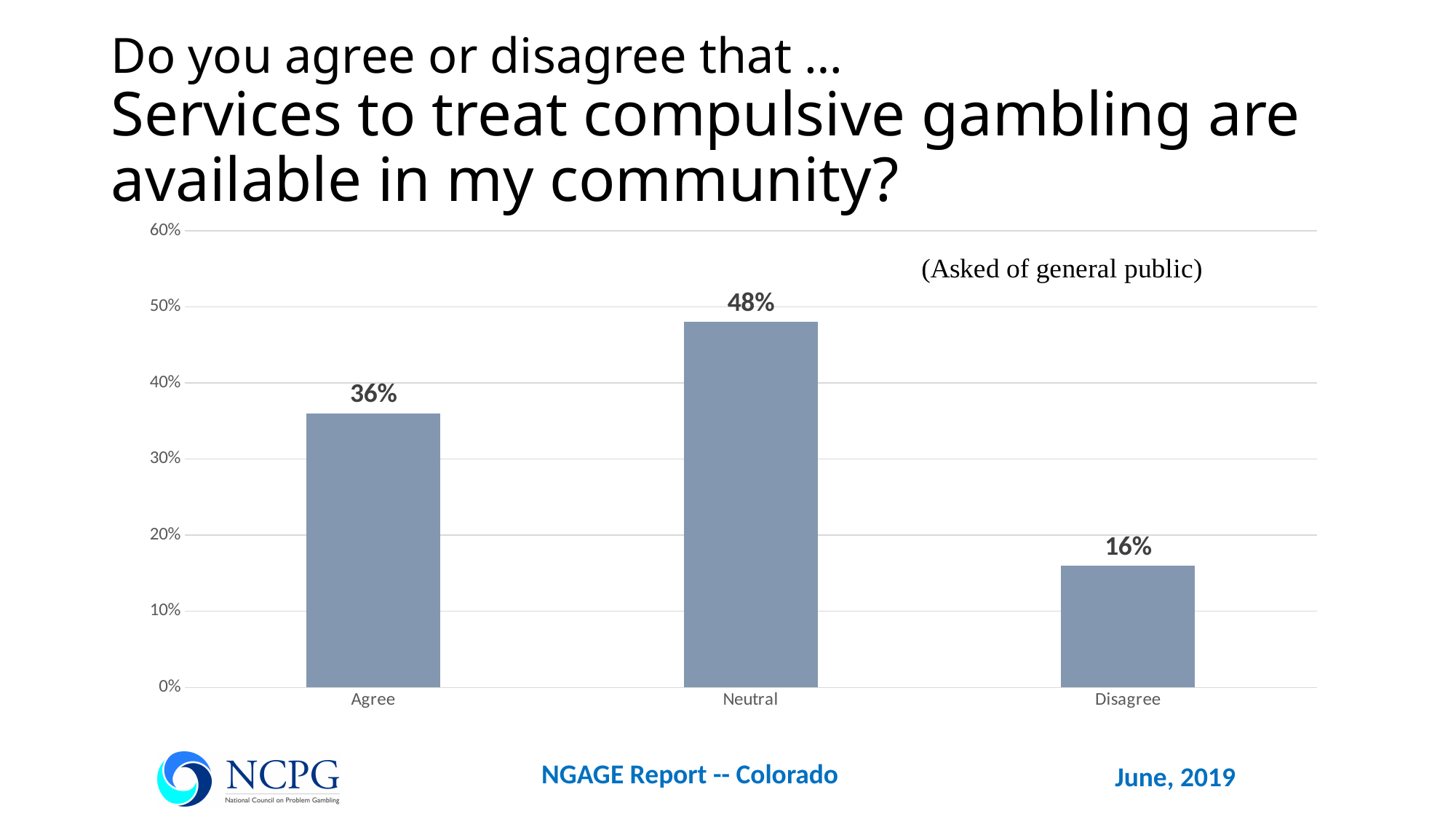
According to the note on the chart, who was this question asked of? general public What kind of chart is shown on the slide? bar chart What is the difference in percentage points between Neutral and Agree? 12 What is the difference in percentage points between Agree and Disagree? 20 How many response categories are shown on the x axis? 3 Which response category has the highest percentage? Neutral Which is larger, the value for Agree or the value for Disagree? Agree Is the value for Neutral greater or less than 40%? greater What percentage of respondents answered Agree? 36% What percentage of respondents answered Disagree? 16% What percentage of respondents answered Neutral? 48% Which response category has the lowest percentage? Disagree